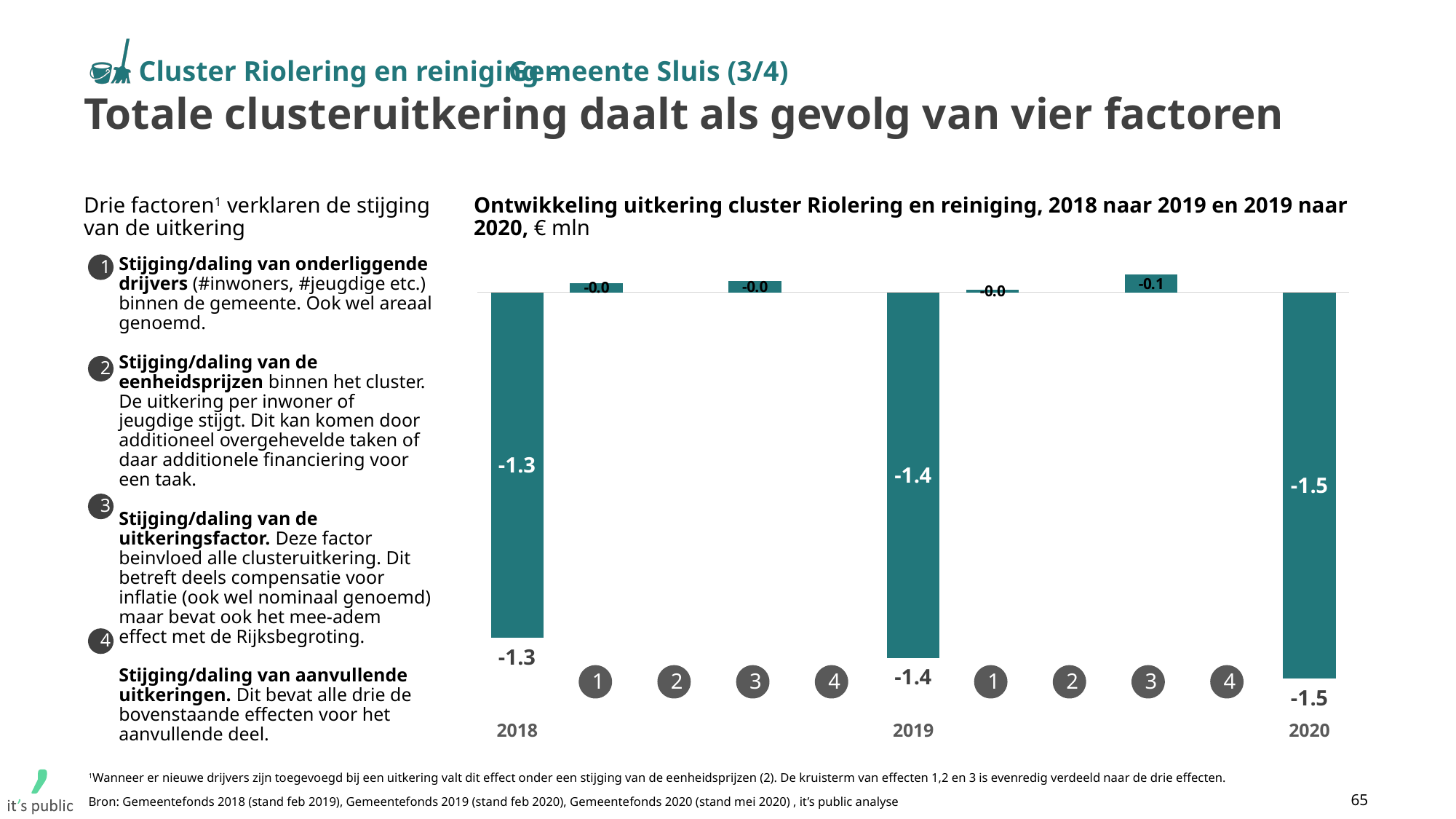
What is the value labelled for factor 1 in the 2018 to 2019 step? -0.0 Do the yearly total values rise or fall from 2018 to 2020? fall What is the value of the 2019 bar? -1.4 What is the value of the 2020 bar? -1.5 What is the value labelled for factor 3 in the 2019 to 2020 step? -0.1 What kind of chart is shown on the slide? bar chart What is the value of the 2018 bar? -1.3 Which year has the lowest (most negative) total value? 2020 In what unit are the chart values expressed? € mln Which is more negative, the 2019 value or the 2020 value? 2020 What is the difference between the 2018 value and the 2020 value? 0.2 Which year has the highest (least negative) total value? 2018